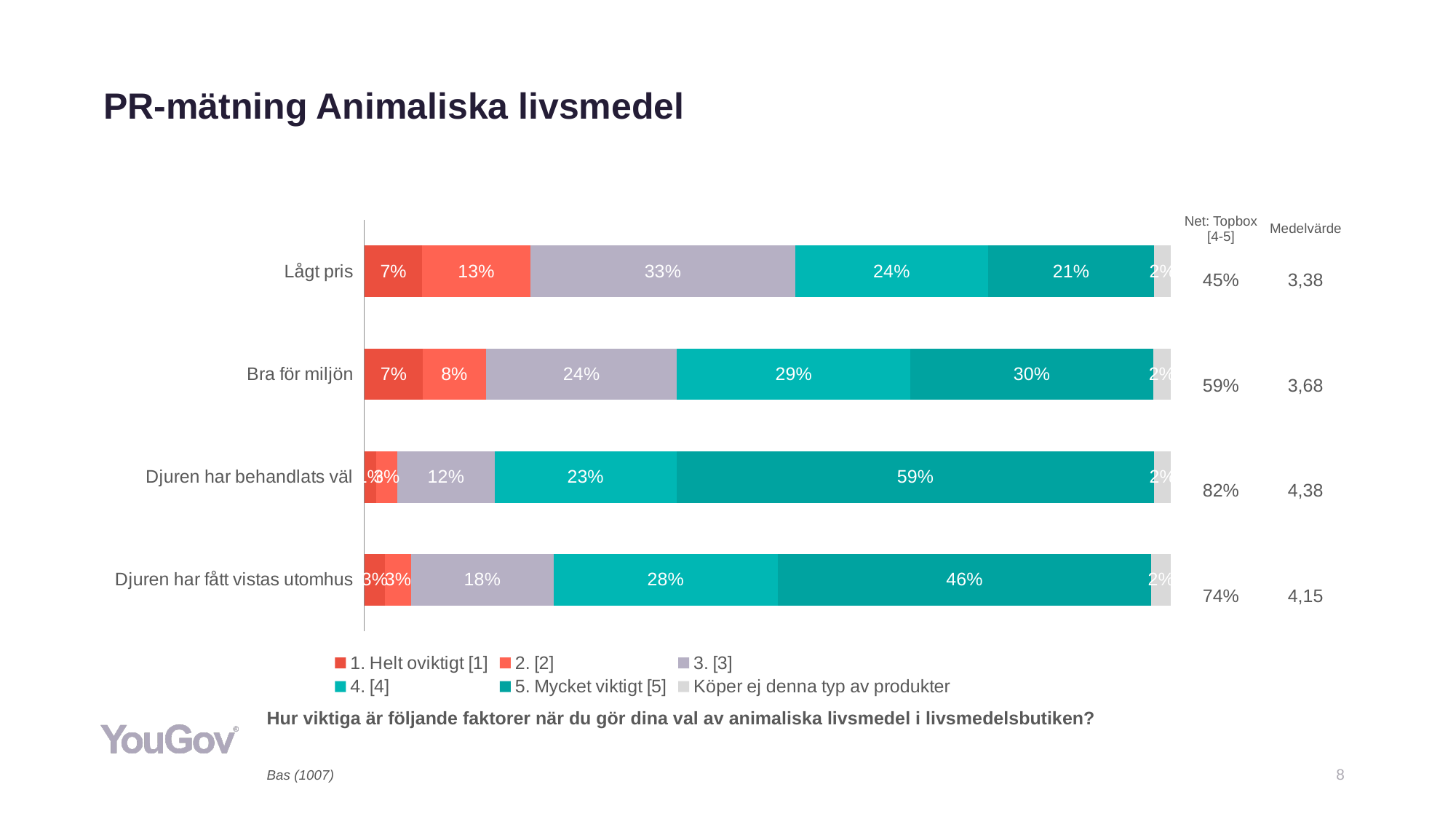
What is the Net: Topbox [4-5] value shown for "Bra för miljön"? 59% What percentage of respondents rated "Lågt pris" as "3. [3]"? 33% Which category has the highest "5. Mycket viktigt [5]" share? Djuren har behandlats väl Which category has the lowest "5. Mycket viktigt [5]" share? Lågt pris How many series does the legend list? 6 What is the "4. [4]" value for "Djuren har fått vistas utomhus"? 28% What is the Medelvärde shown for "Djuren har behandlats väl"? 4,38 How many categories (factors) are shown on the chart? 4 For "Lågt pris", what is the difference between the "4. [4]" value and the "5. Mycket viktigt [5]" value? 3 percentage points What kind of chart is shown on the slide? Stacked bar chart What is the "5. Mycket viktigt [5]" value for "Bra för miljön"? 30% Which has a larger "2. [2]" share: "Lågt pris" or "Bra för miljön"? Lågt pris